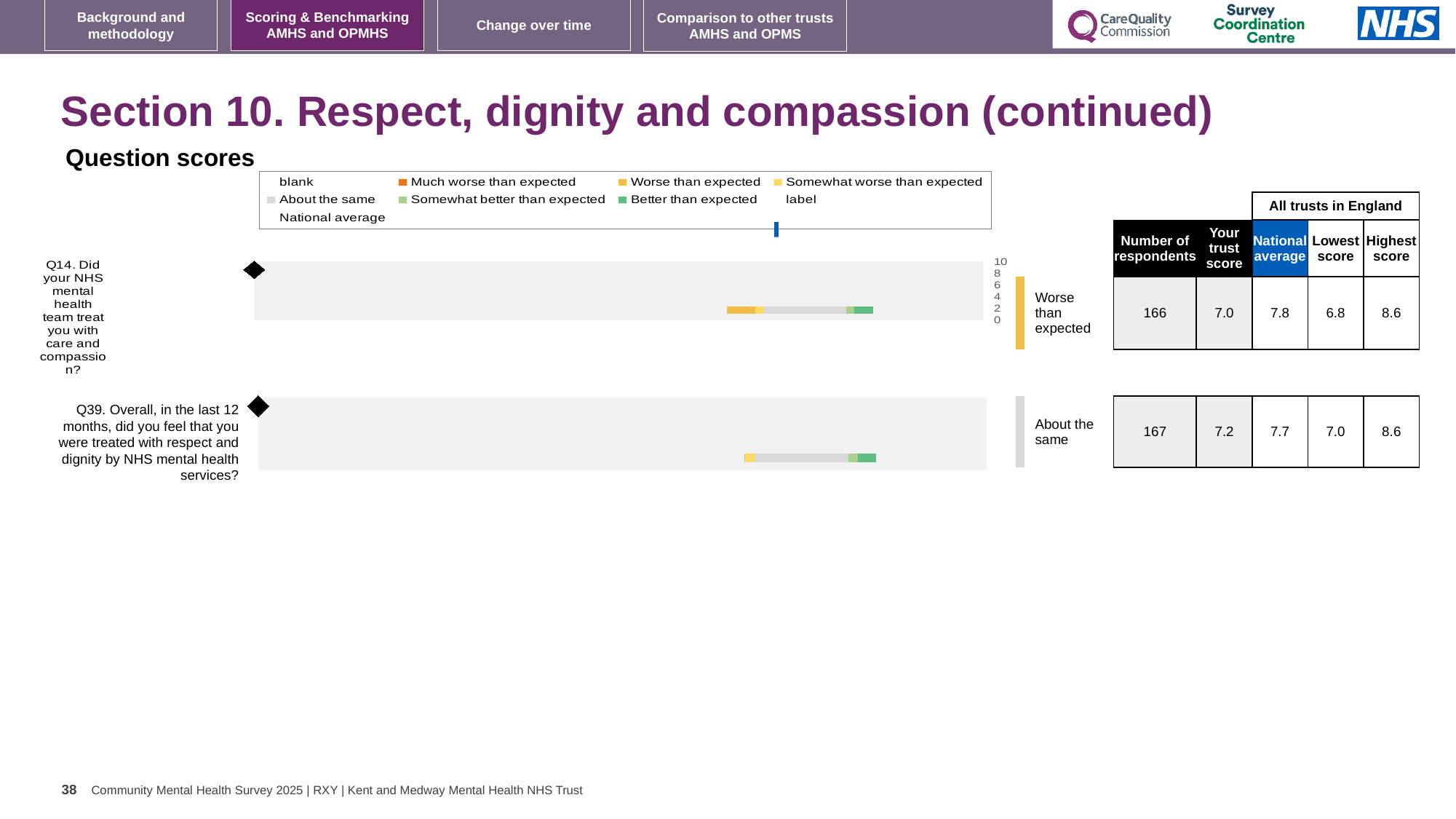
What is the number of respondents for Q39 in the question scores table? 167 What is the trust score for Q14 in the question scores table? 7.0 How many questions are plotted in the question scores chart? 2 What is the highest score across all trusts in England for Q39? 8.6 What is the national average for Q14 in the question scores table? 7.8 What is the difference between the national average and the trust score for Q14? 0.8 Which benchmark category is shown for Q39 in the question scores chart? About the same What kind of chart is used to show the question scores on this slide? bar chart Which question has the higher trust score, Q14 or Q39? Q39 What is the trust score for Q39 in the question scores table? 7.2 Which benchmark category is shown for Q14 in the question scores chart? Worse than expected What is the lowest score across all trusts in England for Q14? 6.8